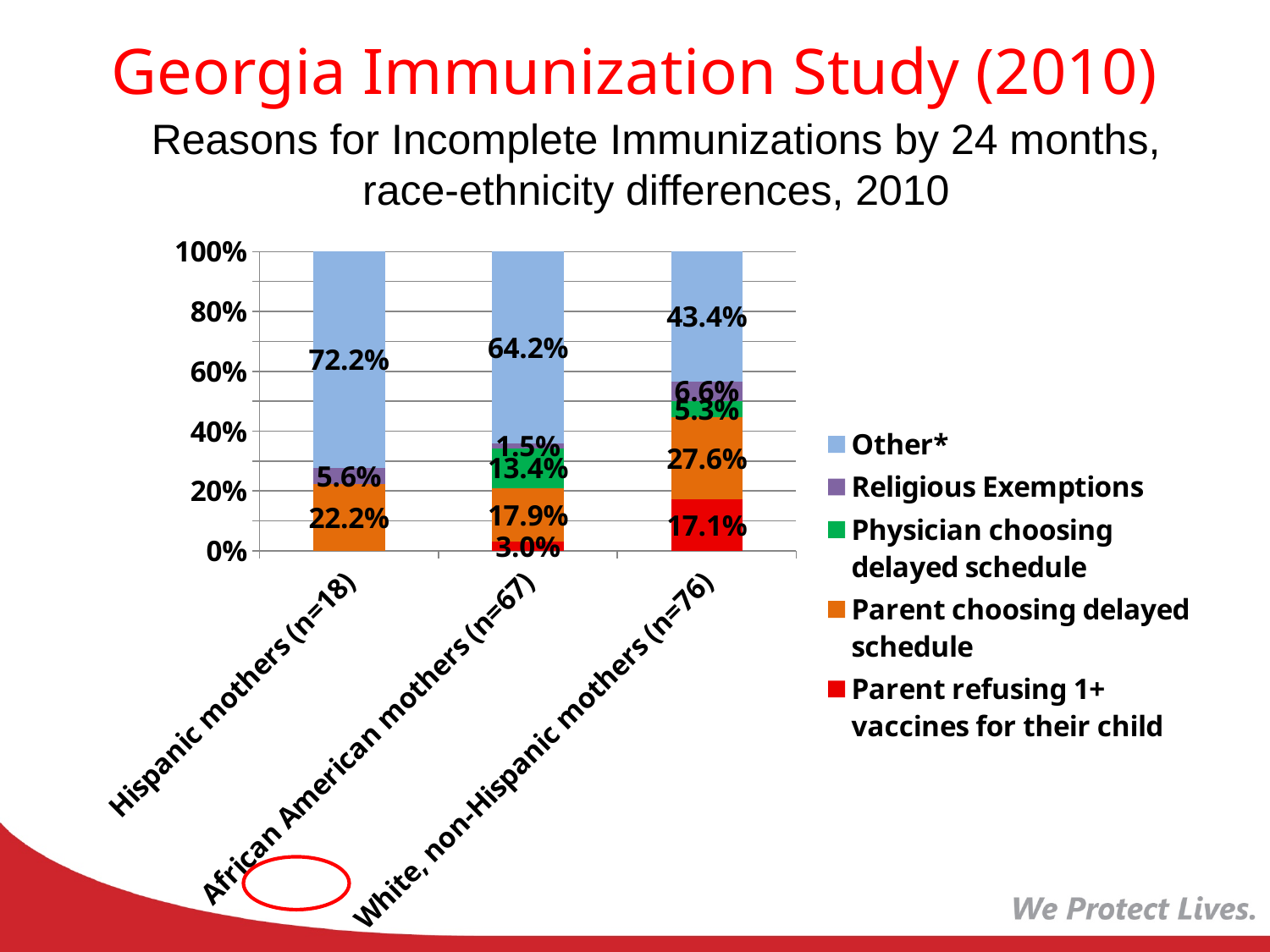
Which group of mothers has the lowest value for 'Parent choosing delayed schedule'? African American mothers (n=67) How many categories (groups of mothers) are shown on the x axis? 3 What is the value of 'Other*' for Hispanic mothers (n=18)? 72.2% Which group of mothers has the highest value for 'Other*'? Hispanic mothers (n=18) What kind of chart is shown on the slide? stacked bar chart What is the value of 'Religious Exemptions' for White, non-Hispanic mothers (n=76)? 6.6% What is the value of 'Parent refusing 1+ vaccines for their child' for White, non-Hispanic mothers (n=76)? 17.1% Which colour represents 'Religious Exemptions' in the legend? purple Which is larger: 'Parent choosing delayed schedule' for Hispanic mothers (n=18) or for White, non-Hispanic mothers (n=76)? White, non-Hispanic mothers (n=76) What is the value of 'Physician choosing delayed schedule' for African American mothers (n=67)? 13.4% How many series does the legend list? 5 What is the difference between the 'Other*' values for Hispanic mothers (n=18) and White, non-Hispanic mothers (n=76)? 28.8%